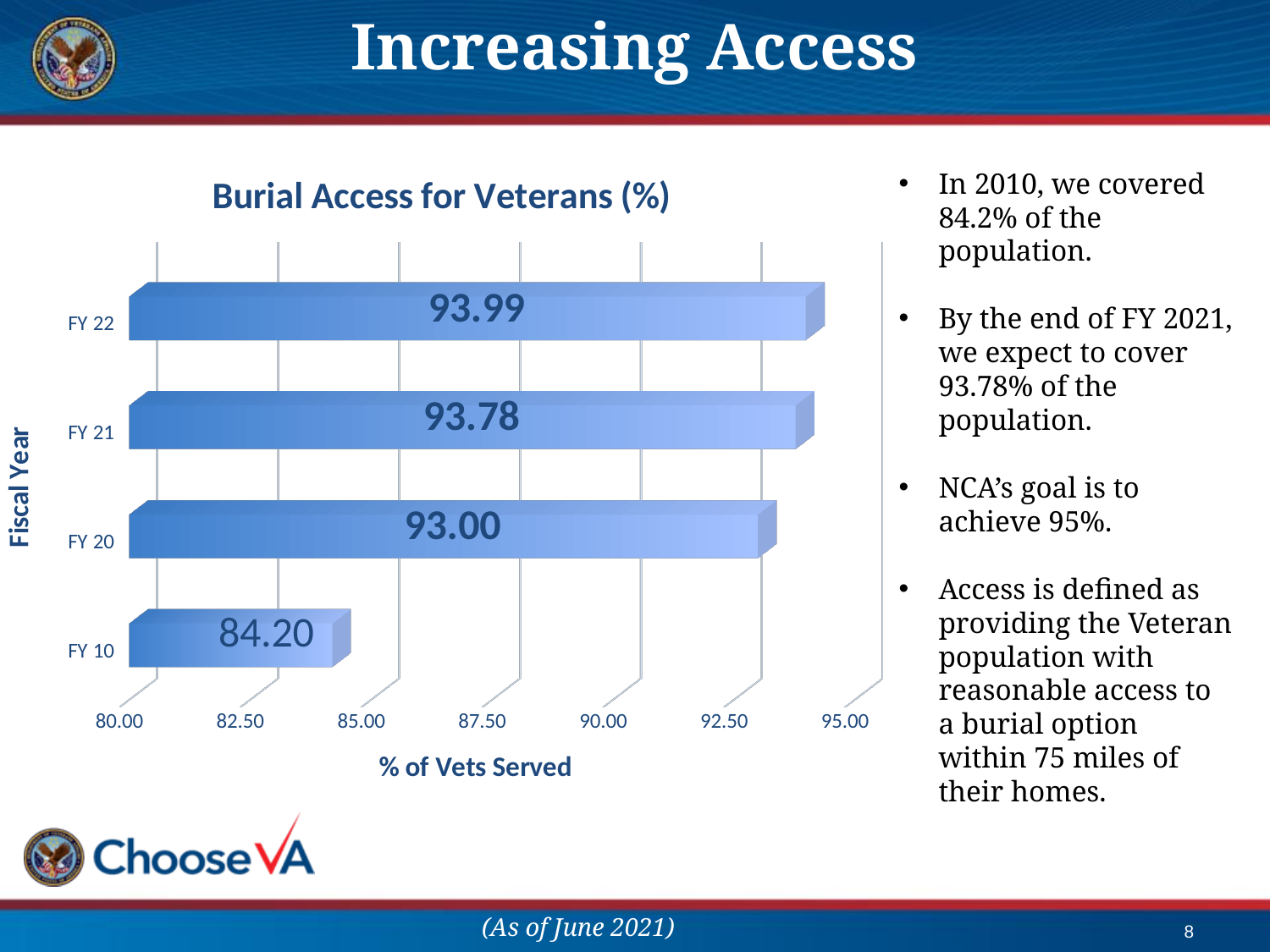
How many fiscal years are shown in the Burial Access for Veterans (%) chart? 4 Which fiscal year has the highest value in the Burial Access for Veterans (%) chart? FY 22 Which fiscal year has the lowest value in the Burial Access for Veterans (%) chart? FY 10 What is the difference between the FY 22 and FY 10 values in the Burial Access for Veterans (%) chart? 9.79 What is the difference between the FY 21 and FY 20 values in the Burial Access for Veterans (%) chart? 0.78 Is the value for FY 21 greater or less than 92.50 in the Burial Access for Veterans (%) chart? greater What is the label of the horizontal axis in the Burial Access for Veterans (%) chart? % of Vets Served Which is larger in the Burial Access for Veterans (%) chart, the value for FY 20 or the value for FY 10? FY 20 What is the value for FY 10 in the Burial Access for Veterans (%) chart? 84.20 What is the value for FY 20 in the Burial Access for Veterans (%) chart? 93.00 What kind of chart is the Burial Access for Veterans (%) chart? bar chart What is the value for FY 22 in the Burial Access for Veterans (%) chart? 93.99